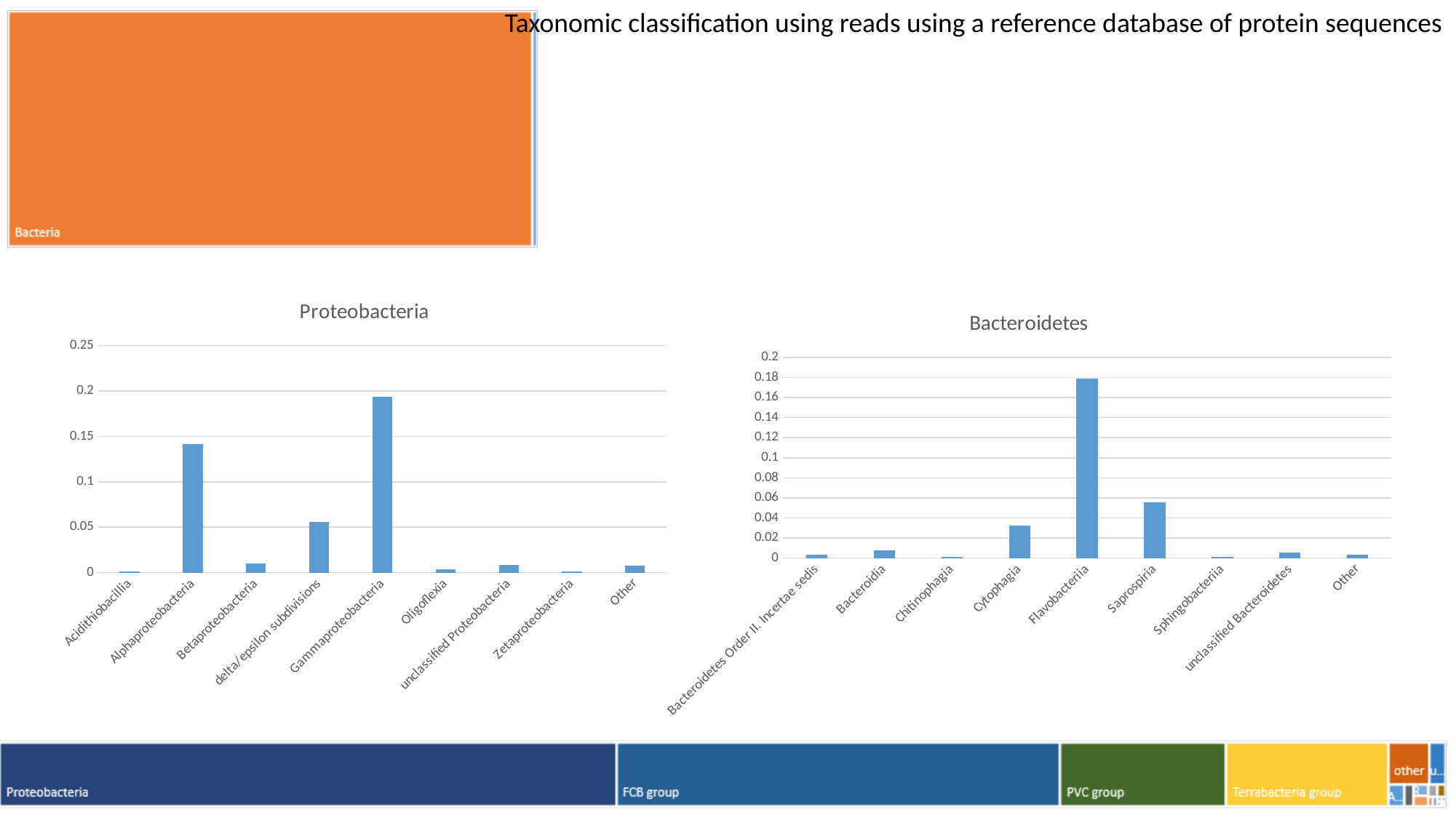
In the Bacteroidetes chart, is the value for Cytophagia greater or less than 0.04? less In the Proteobacteria chart, is the value for delta/epsilon subdivisions greater or less than 0.1? less In the Bacteroidetes chart, which category has the highest value? Flavobacteriia How many categories are shown on the x axis of the Bacteroidetes chart? 9 How many categories are shown on the x axis of the Proteobacteria chart? 9 In the Bacteroidetes chart, which is larger, the value for Saprospiria or the value for Cytophagia? Saprospiria In the Proteobacteria chart, which category has the highest value? Gammaproteobacteria What is the title of the bar chart on the right side of the slide? Bacteroidetes What kind of chart is the Proteobacteria chart? bar chart In the Bacteroidetes chart, is the value for Flavobacteriia greater or less than 0.16? greater